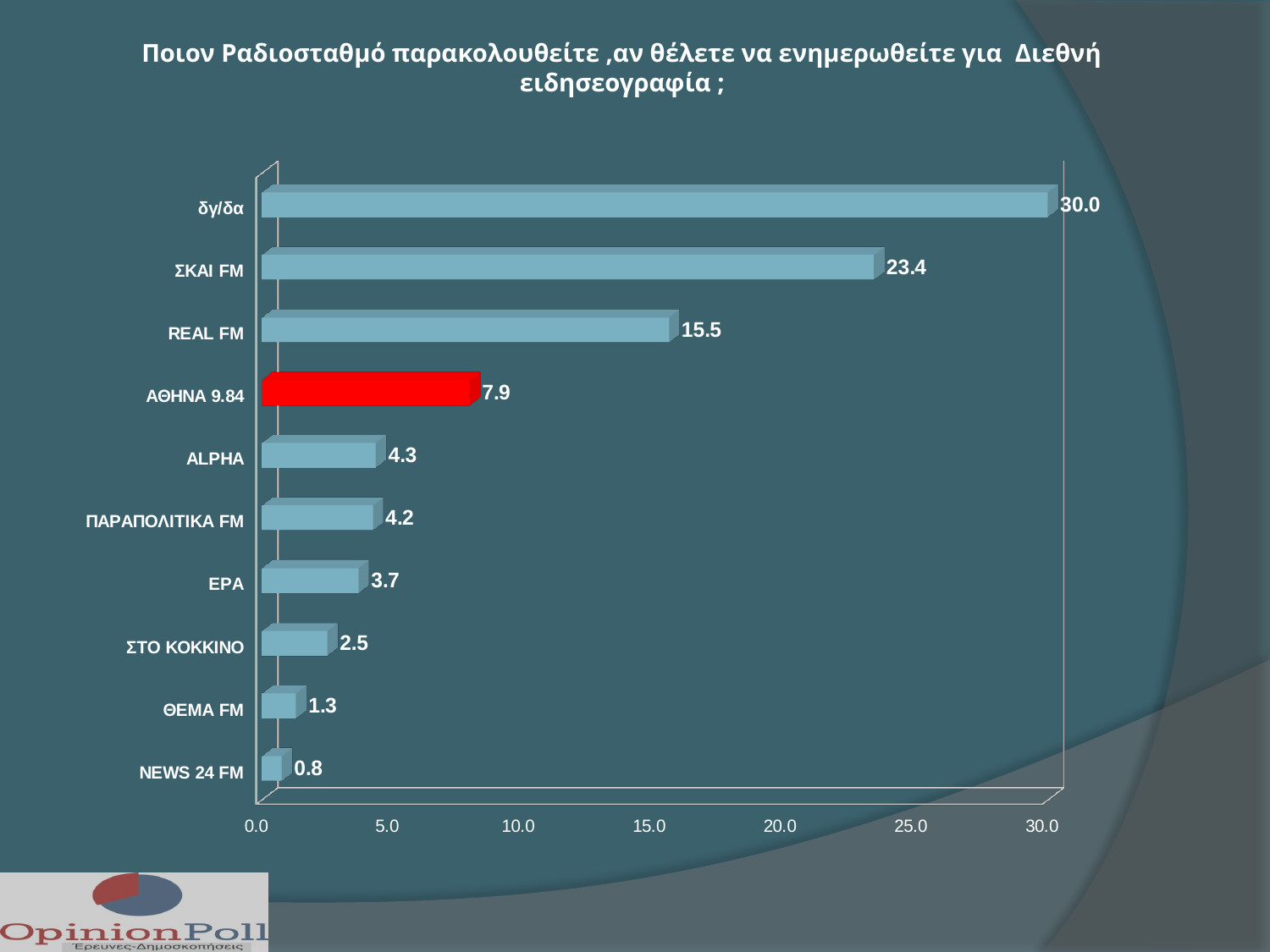
Which is larger, the value for ΕΡΑ or the value for ΣΤΟ ΚΟΚΚΙΝΟ? ΕΡΑ What kind of chart is shown on the slide? bar chart What is the value for ΑΘΗΝΑ 9.84? 7.9 What is the value for ΠΑΡΑΠΟΛΙΤΙΚΑ FM? 4.2 What is the difference between the values for ALPHA and ΘΕΜΑ FM? 3.0 What is the value for ΣΚΑΙ FM? 23.4 How many categories are shown in the chart? 10 Which bar is coloured red? ΑΘΗΝΑ 9.84 Which category has the highest value? δγ/δα Is the value for REAL FM greater or less than 10.0? greater What is the difference between the values for ΣΚΑΙ FM and REAL FM? 7.9 Which category has the lowest value? NEWS 24 FM